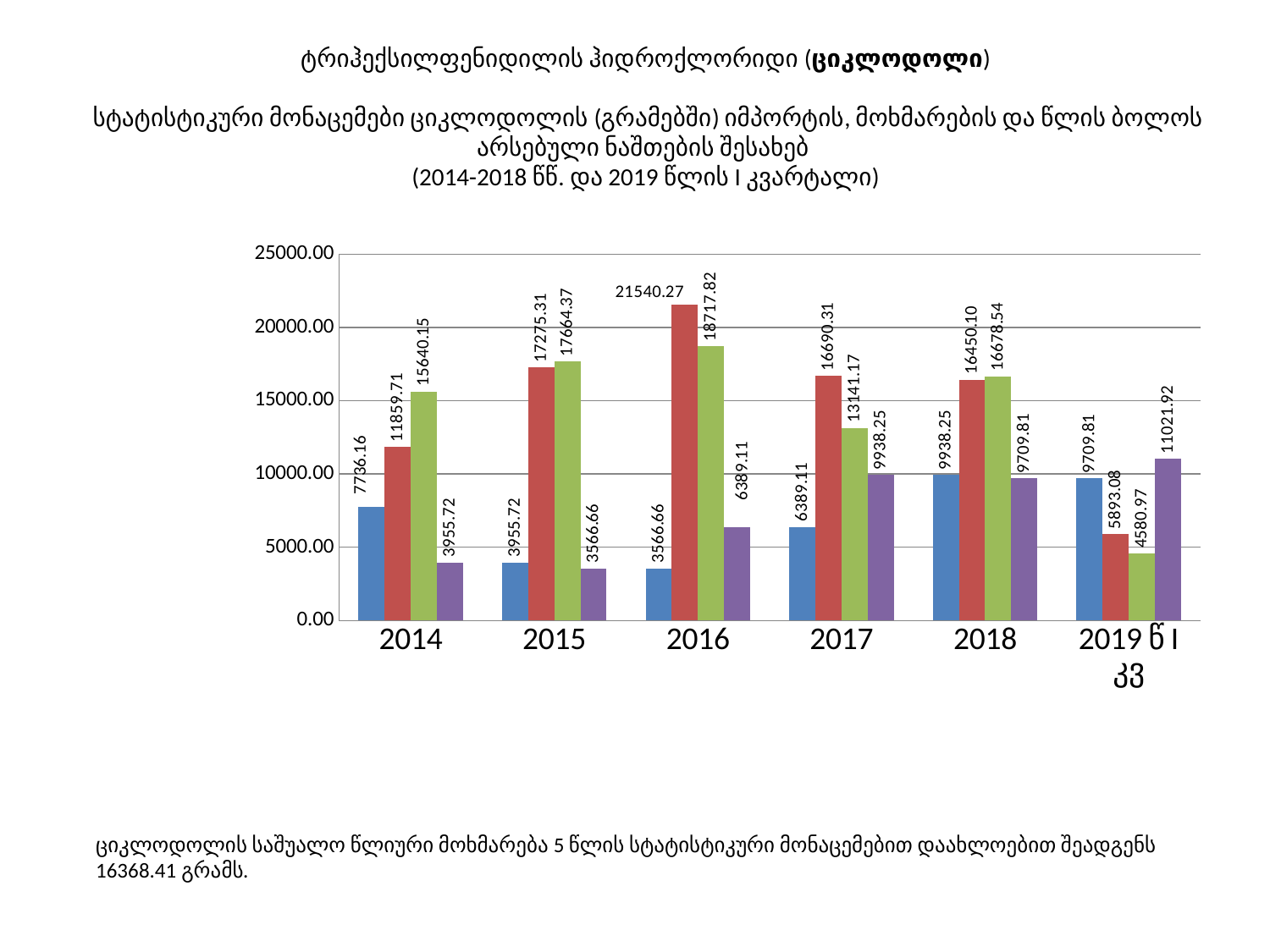
Which is larger for 2017, the red bar or the green bar? the red bar What is the difference between the red bar and the green bar for 2016? 2822.45 How many bars are shown for each category in the chart? 4 What is the value of the green bar for 2014? 15640.15 What is the value of the purple bar for 2019 წ I კვ? 11021.92 How many categories are shown on the x axis of the chart? 6 What type of chart is shown on the slide? bar chart What is the value of the red bar for 2016? 21540.27 Which category has the lowest blue bar? 2016 Which category has the highest red bar? 2016 What is the value of the blue bar for 2018? 9938.25 Is the value of the purple bar for 2015 greater or less than 5000.00? less